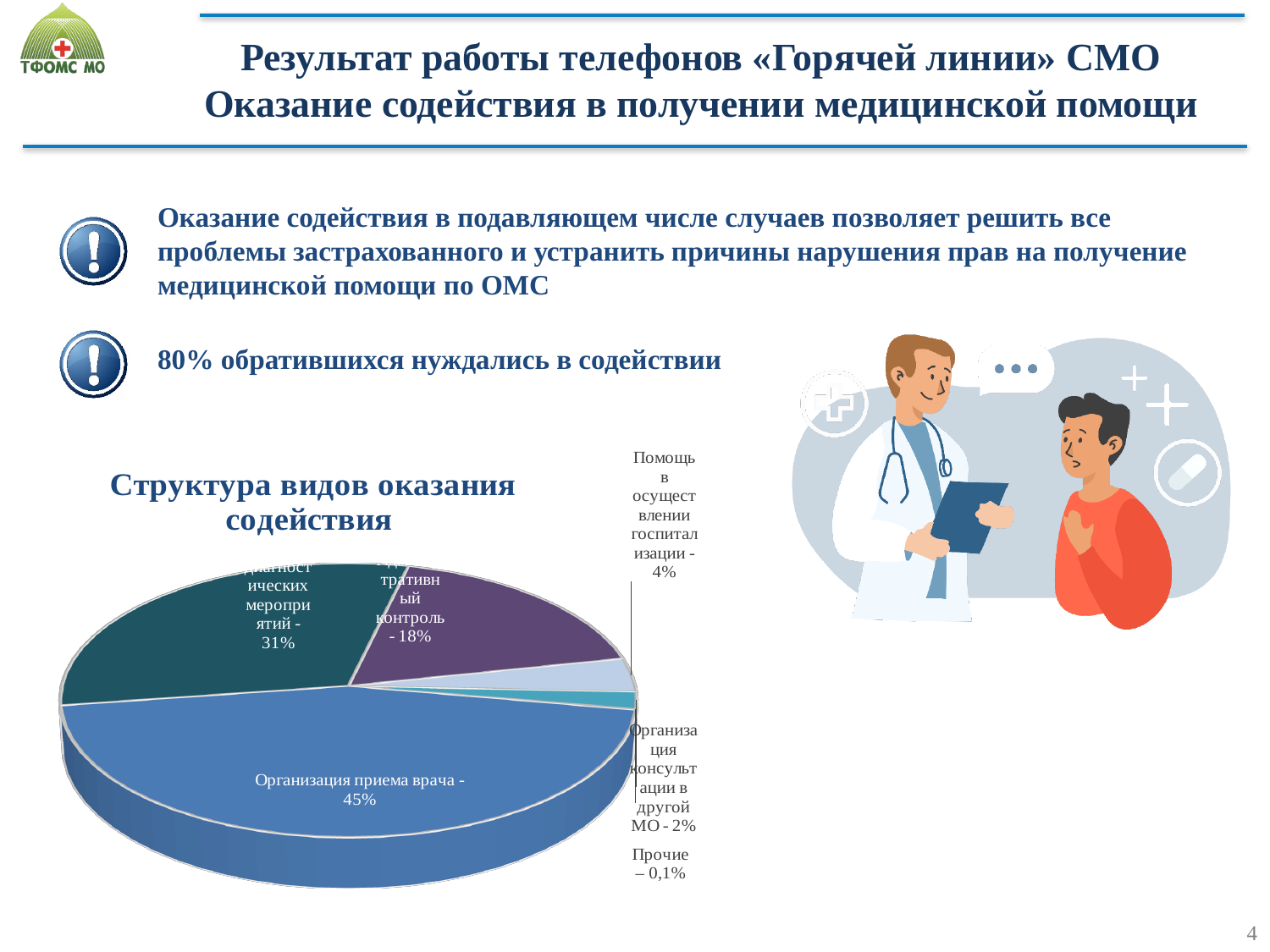
Which category has the smallest slice of the pie? Прочие Which is larger: the share for «Помощь в осуществлении госпитализации» or the share for «Организация консультации в другой МО»? Помощь в осуществлении госпитализации What kind of chart is shown under the title «Структура видов оказания содействия»? Pie chart What is the title of the chart on the slide? Структура видов оказания содействия How many slices does the pie chart have? 6 What is the value shown for «Организация консультации в другой МО»? 2% What is the value shown for «Помощь в осуществлении госпитализации»? 4% What is the value shown for «Прочие»? 0,1% What share of the pie does «Организация приема врача» account for? 45% What is the difference between the share for «Организация консультации в другой МО» and the share for «Прочие»? 1,9% Which category has the largest slice of the pie? Организация приема врача What is the difference between the share for «Организация приема врача» and the share for «Помощь в осуществлении госпитализации»? 41%